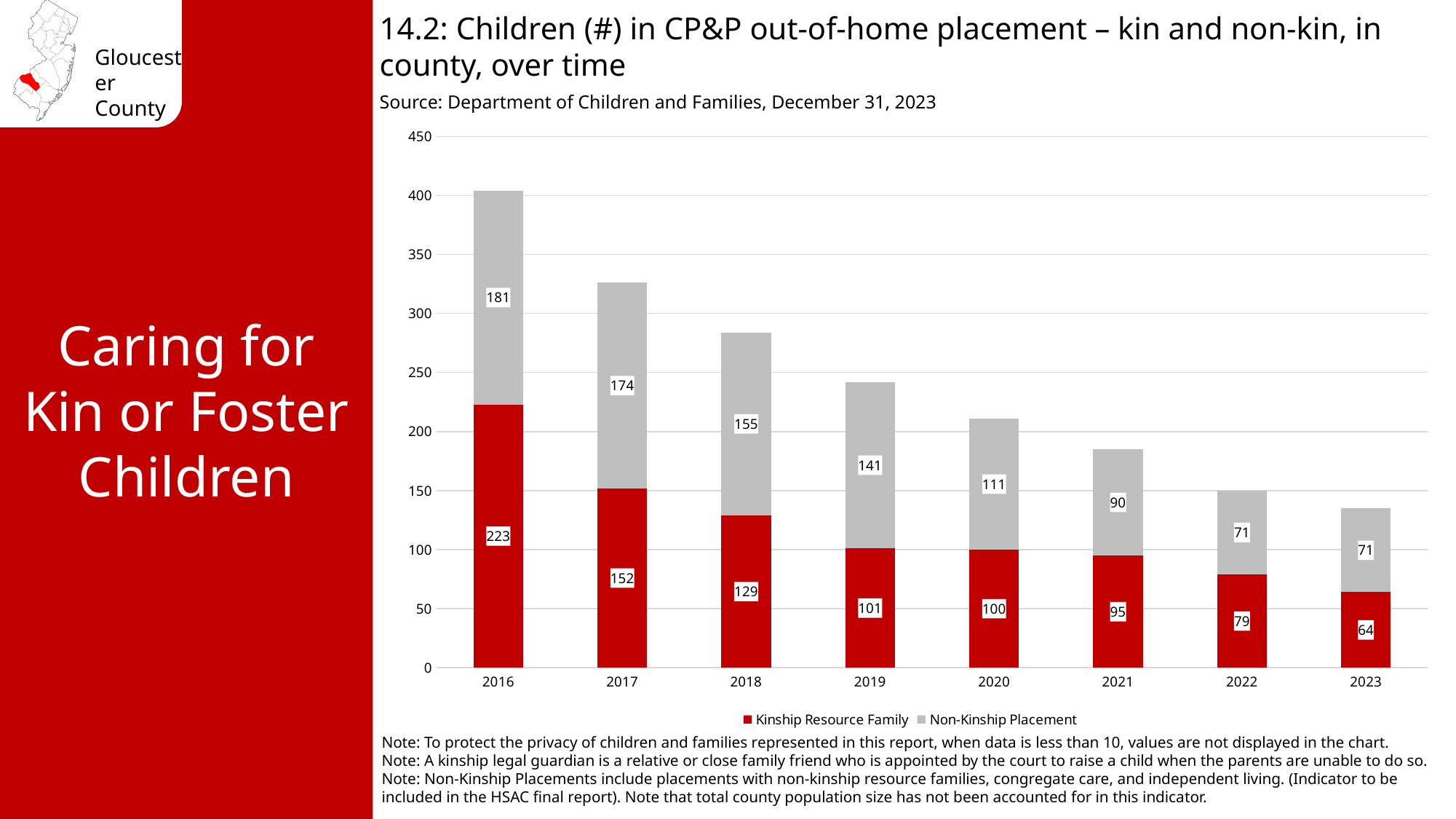
What kind of chart is shown? Stacked bar chart What is the Non-Kinship Placement value for 2019? 141 What is the total of the stacked bar for 2016? 404 How many series does the legend list? 2 Which is larger, the Kinship Resource Family value for 2018 or the Non-Kinship Placement value for 2018? Non-Kinship Placement (155) What is the Kinship Resource Family value for 2016? 223 How many years are shown on the x axis? 8 Which year has the lowest Non-Kinship Placement value? 2022 and 2023 (both 71) Which year has the highest Kinship Resource Family value? 2016 What is the difference between the Non-Kinship Placement values for 2016 and 2017? 7 What is the Kinship Resource Family value for 2023? 64 What is the total of the stacked bar for 2020? 211